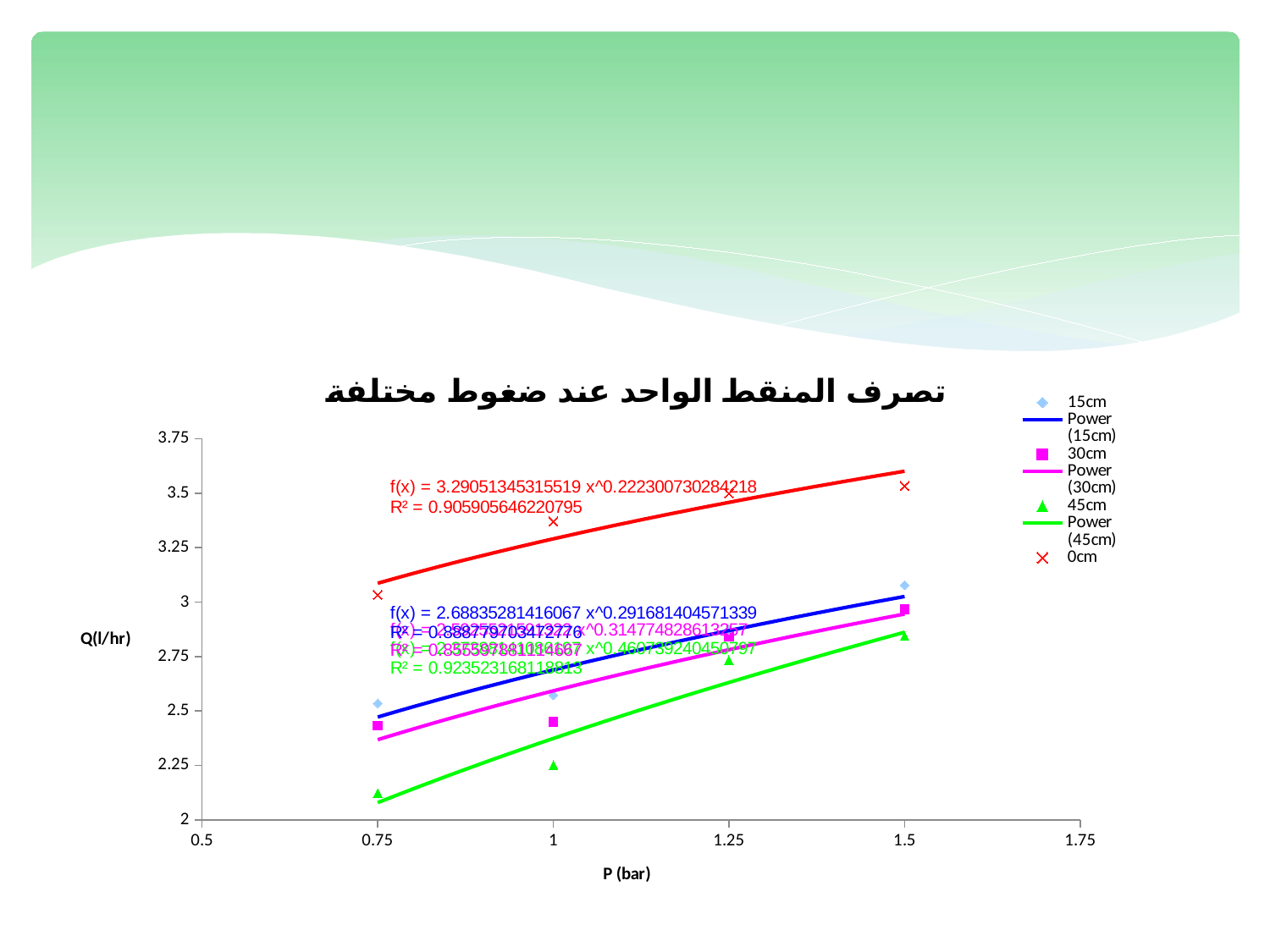
What R² value is shown for the red (0cm) power trendline? 0.905905646220795 Is the value for 45cm at P = 0.75 bar greater or less than 2.25? less What is the label of the x axis? P (bar) Which series has the highest discharge values across all pressures? 0cm At how many pressure values are data points plotted? 4 Is the value for 0cm at P = 1 bar greater or less than 3.25? greater How many entries does the legend list? 7 Do the discharge values rise or fall as pressure increases along the x axis? rise Which series has the lowest discharge values across all pressures? 45cm At P = 1 bar, which is larger, the 0cm value or the 45cm value? 0cm Is the value for 30cm at P = 0.75 bar greater or less than 2.5? less What kind of chart is shown on the slide? scatter chart